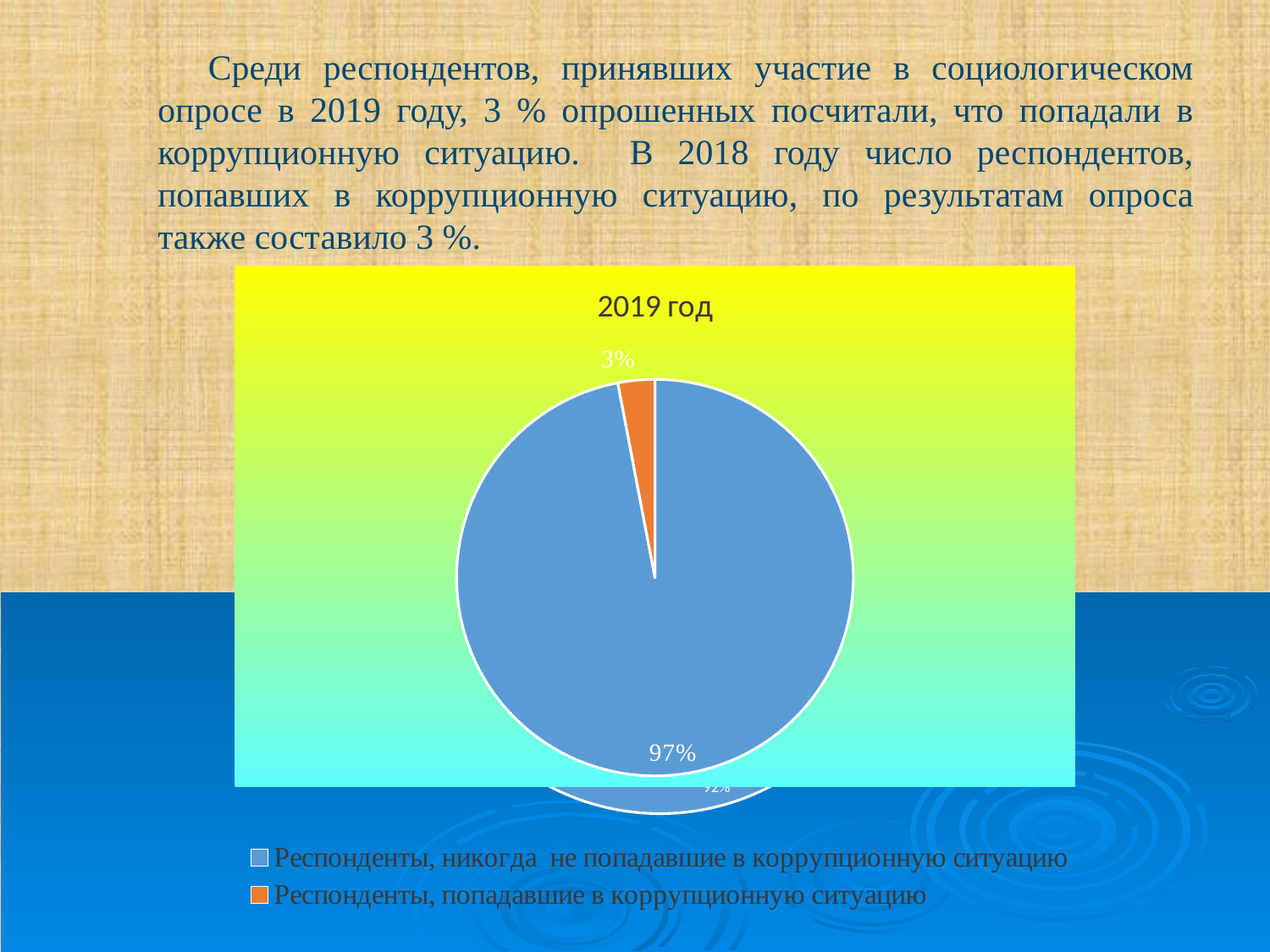
What is the title of the pie chart? 2019 год What kind of chart is shown on the slide? pie chart Which slice is larger: the one for respondents who never encountered a corruption situation or the one for respondents who did? Респонденты, никогда не попадавшие в коррупционную ситуацию What is the difference in percentage points between the 97% slice and the 3% slice? 94 What is the share of the pie taken by the orange slice? 3% How many entries does the legend list? 2 Which category has the largest slice of the pie? Респонденты, никогда не попадавшие в коррупционную ситуацию What colour is the slice for respondents who encountered a corruption situation? orange Which category has the smallest slice of the pie? Респонденты, попадавшие в коррупционную ситуацию How many slices does the pie chart have? 2 What share of the pie is labelled for respondents who never encountered a corruption situation (Респонденты, никогда не попадавшие в коррупционную ситуацию)? 97% What share of the pie is labelled for respondents who encountered a corruption situation (Респонденты, попадавшие в коррупционную ситуацию)? 3%